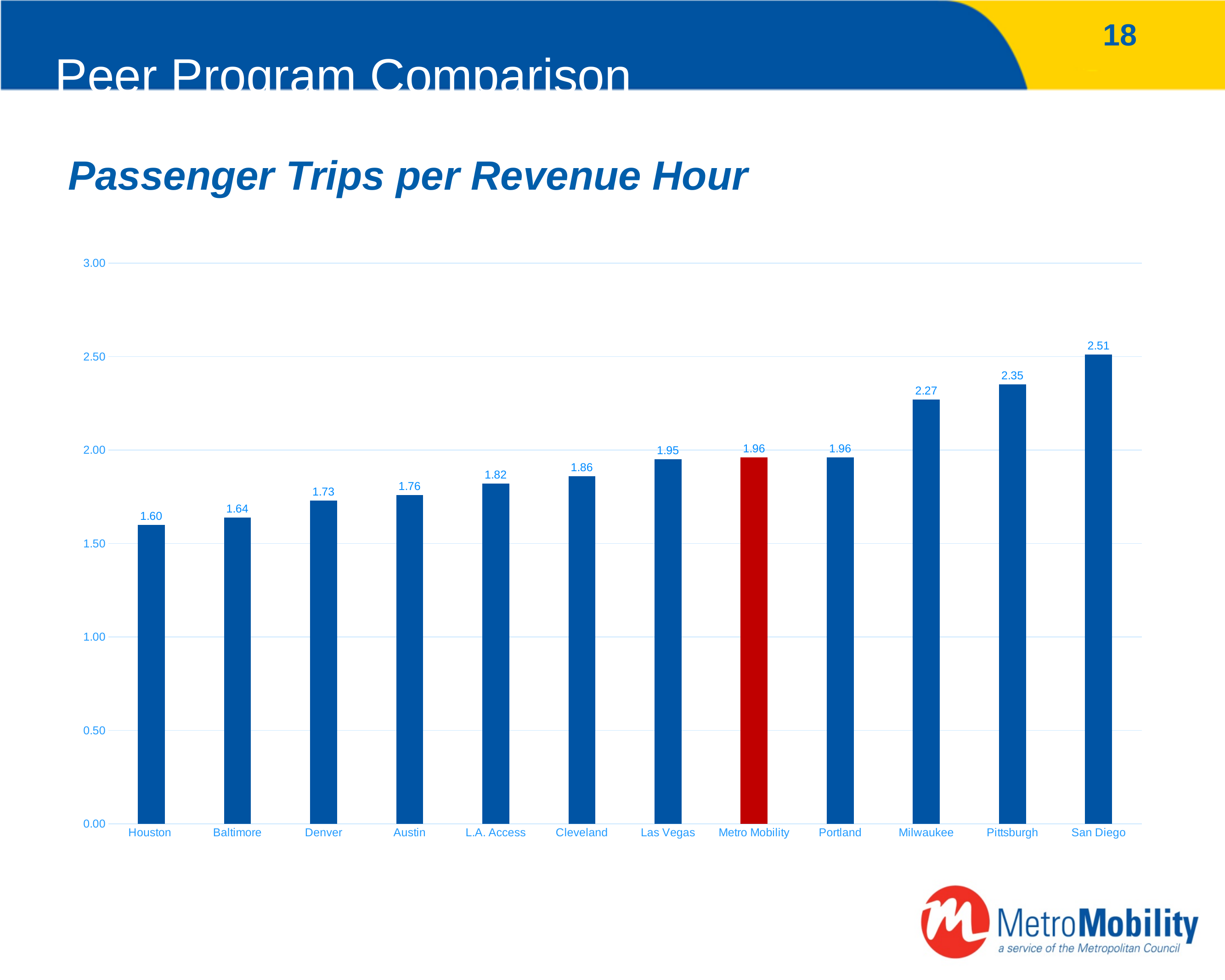
Which bar is coloured red rather than blue? Metro Mobility What is the value for Houston? 1.60 Is the value for Pittsburgh greater or less than 2.00? greater What is the difference between the values for Pittsburgh and Milwaukee? 0.08 Which category has the lowest value? Houston Which is larger, the value for Cleveland or the value for Denver? Cleveland Which category has the highest value? San Diego What is the value for Milwaukee? 2.27 What is the value for Metro Mobility? 1.96 What kind of chart is shown on the slide? bar chart How many categories are shown on the x axis? 12 What is the difference between the values for San Diego and Houston? 0.91